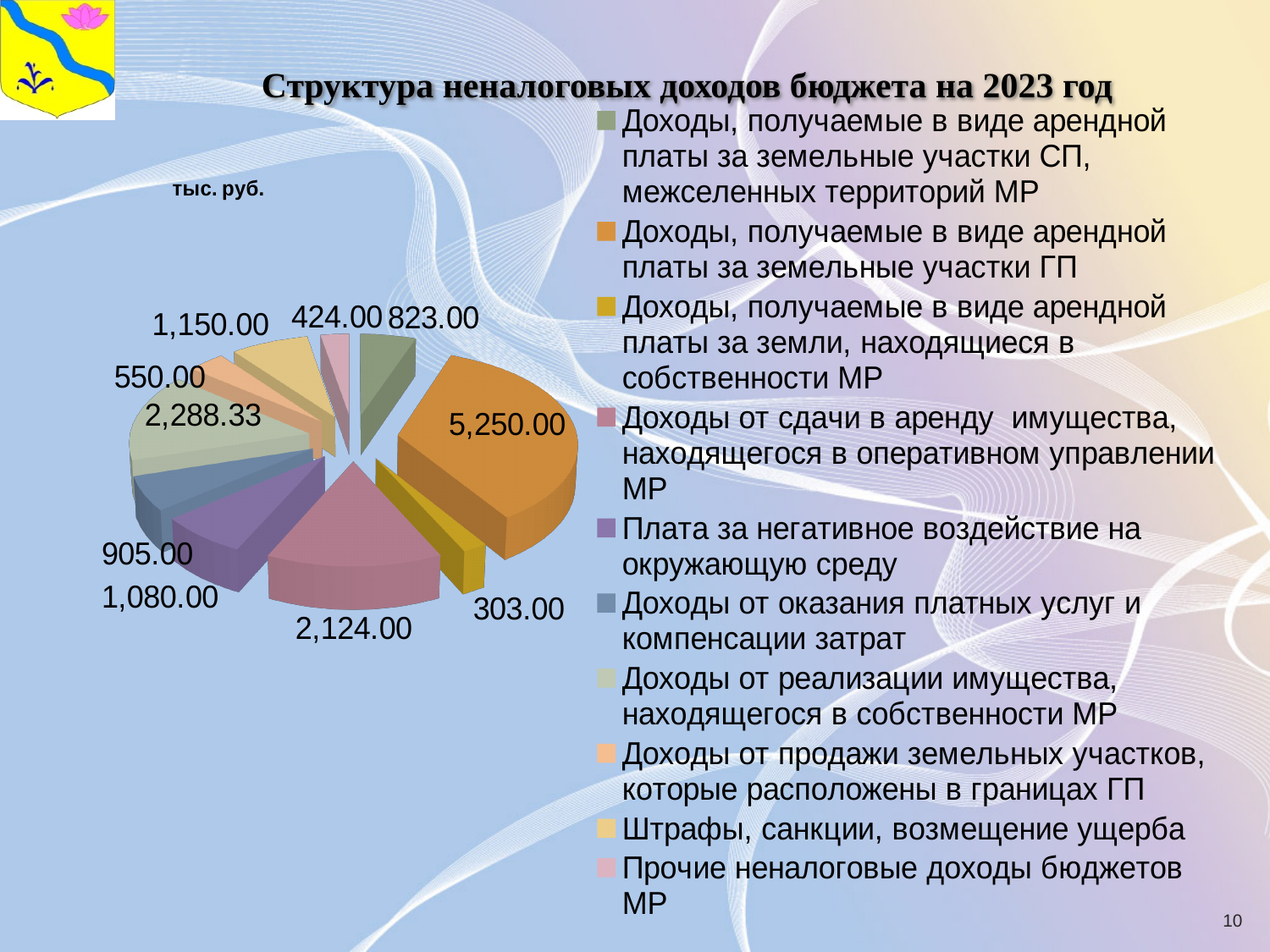
How many slices does the pie chart have? 10 What is the difference between the value for 'Доходы от сдачи в аренду имущества, находящегося в оперативном управлении МР' (2,124.00) and 'Плата за негативное воздействие на окружающую среду' (1,080.00)? 1,044.00 How many entries does the legend list? 10 What is the value for 'Доходы, получаемые в виде арендной платы за земельные участки ГП'? 5,250.00 What is the value for 'Штрафы, санкции, возмещение ущерба'? 1,150.00 What unit is indicated for the values in the chart? тыс. руб. Which category has the smallest value? Доходы, получаемые в виде арендной платы за земли, находящиеся в собственности МР What is the value for 'Доходы от реализации имущества, находящегося в собственности МР'? 2,288.33 What type of chart is shown on the slide? pie chart Which category has the largest value? Доходы, получаемые в виде арендной платы за земельные участки ГП What is the title of the chart? Структура неналоговых доходов бюджета на 2023 год Which is larger: the value for 'Доходы от оказания платных услуг и компенсации затрат' or 'Доходы от продажи земельных участков, которые расположены в границах ГП'? Доходы от оказания платных услуг и компенсации затрат